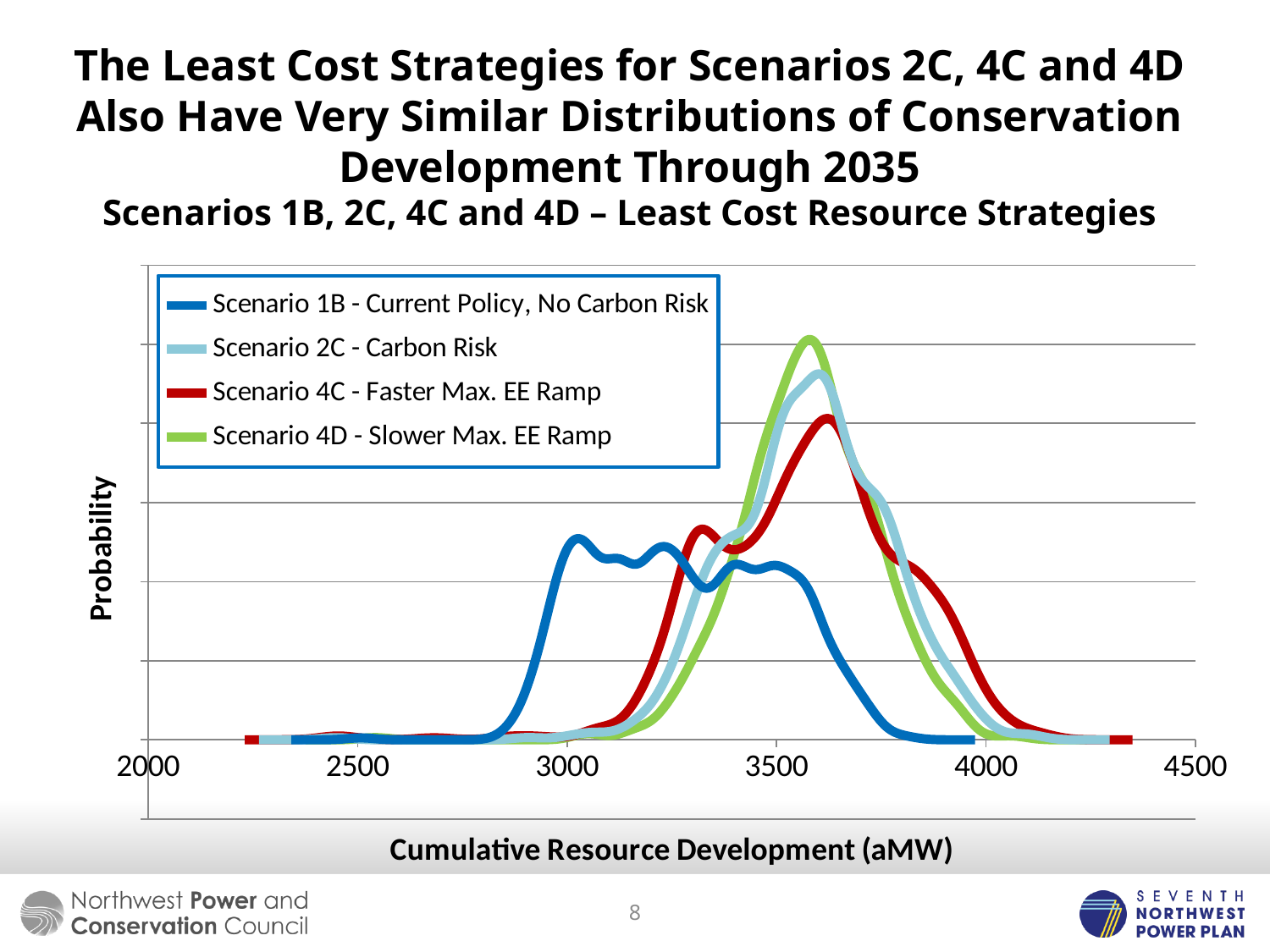
What is the title of the x axis? Cumulative Resource Development (aMW) Which series reaches a higher peak, Scenario 1B - Current Policy, No Carbon Risk or Scenario 4C - Faster Max. EE Ramp? Scenario 4C - Faster Max. EE Ramp What kind of chart is shown on the slide? Line chart Which scenario's distribution reaches the highest peak probability? Scenario 4D - Slower Max. EE Ramp Which scenario's distribution has the lowest peak probability? Scenario 1B - Current Policy, No Carbon Risk How many tick labels are shown on the x axis? 6 What is the title of the y axis? Probability Is the cumulative resource development at the highest point of Scenario 1B - Current Policy, No Carbon Risk greater or less than 3500 aMW? less How many series does the legend list? 4 Is the cumulative resource development at the peak of Scenario 4D - Slower Max. EE Ramp greater or less than 3500 aMW? greater Is the cumulative resource development at the peak of Scenario 4C - Faster Max. EE Ramp greater or less than 4000 aMW? less Which series reaches a higher peak, Scenario 2C - Carbon Risk or Scenario 4C - Faster Max. EE Ramp? Scenario 2C - Carbon Risk